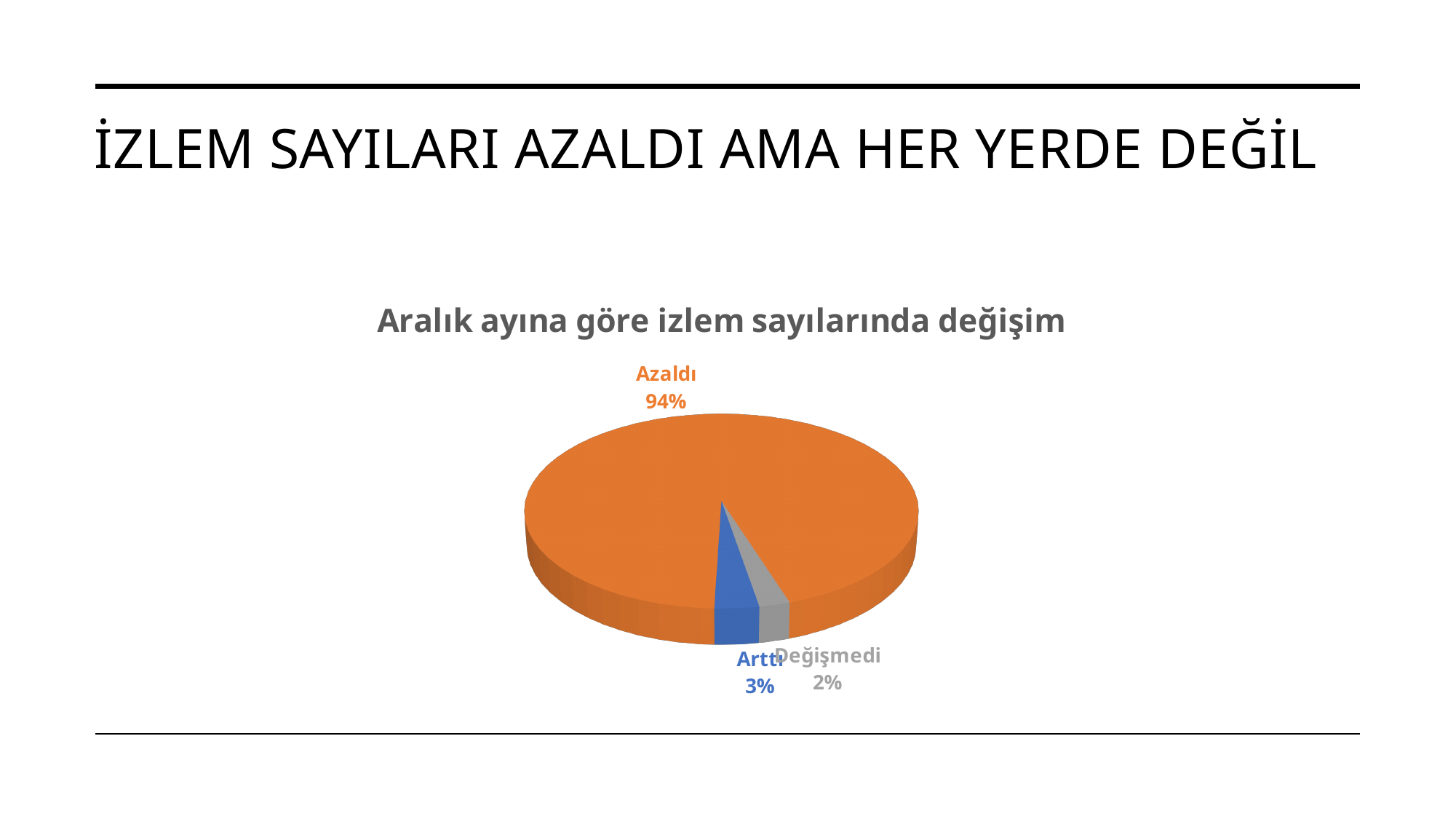
What share of the pie does the 'Azaldı' slice represent? 94% What share of the pie does the 'Değişmedi' slice represent? 2% How many categories are shown in the pie chart? 3 Which is larger, the 'Arttı' slice or the 'Değişmedi' slice? Arttı Which category has the smallest slice of the pie? Değişmedi What is the title of the chart? Aralık ayına göre izlem sayılarında değişim What share of the pie does the 'Arttı' slice represent? 3% What colour is the 'Azaldı' slice? Orange What kind of chart is shown on the slide? Pie chart Which category has the largest slice of the pie? Azaldı What is the difference in percentage points between the 'Azaldı' and 'Arttı' slices? 91